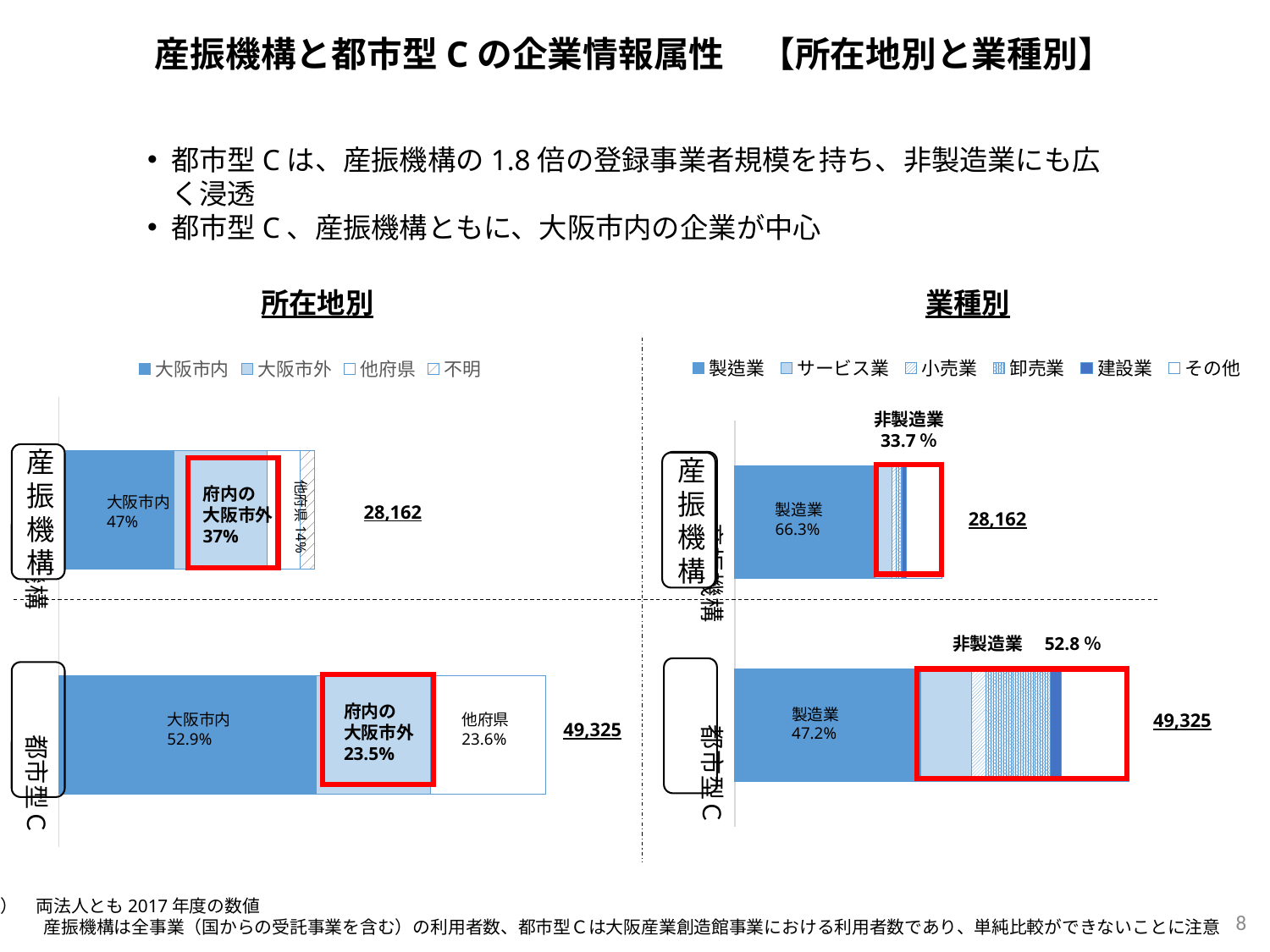
In the 業種別 chart, what total number is shown next to the 都市型C bar? 49,325 In the 所在地別 chart, which has the larger 府内の大阪市外 share, 産振機構 or 都市型C? 産振機構 In the 業種別 chart, what percentage of 産振機構 is 製造業? 66.3% In the 所在地別 chart, what is the difference between the 大阪市内 share of 都市型C and that of 産振機構? 5.9% What kind of chart is the 所在地別 chart? Stacked bar chart In the 所在地別 chart, what percentage of 都市型C is 他府県? 23.6% In the 業種別 chart, what is the difference between the 製造業 share of 産振機構 and that of 都市型C? 19.1% In the 所在地別 chart, what percentage of 都市型C is 府内の大阪市外? 23.5% How many series does the legend of the 所在地別 chart list? 4 In the 業種別 chart, what is the 非製造業 share for 都市型C? 52.8% How many series does the legend of the 業種別 chart list? 6 In the 所在地別 chart, what percentage of 産振機構 is 大阪市内? 47%